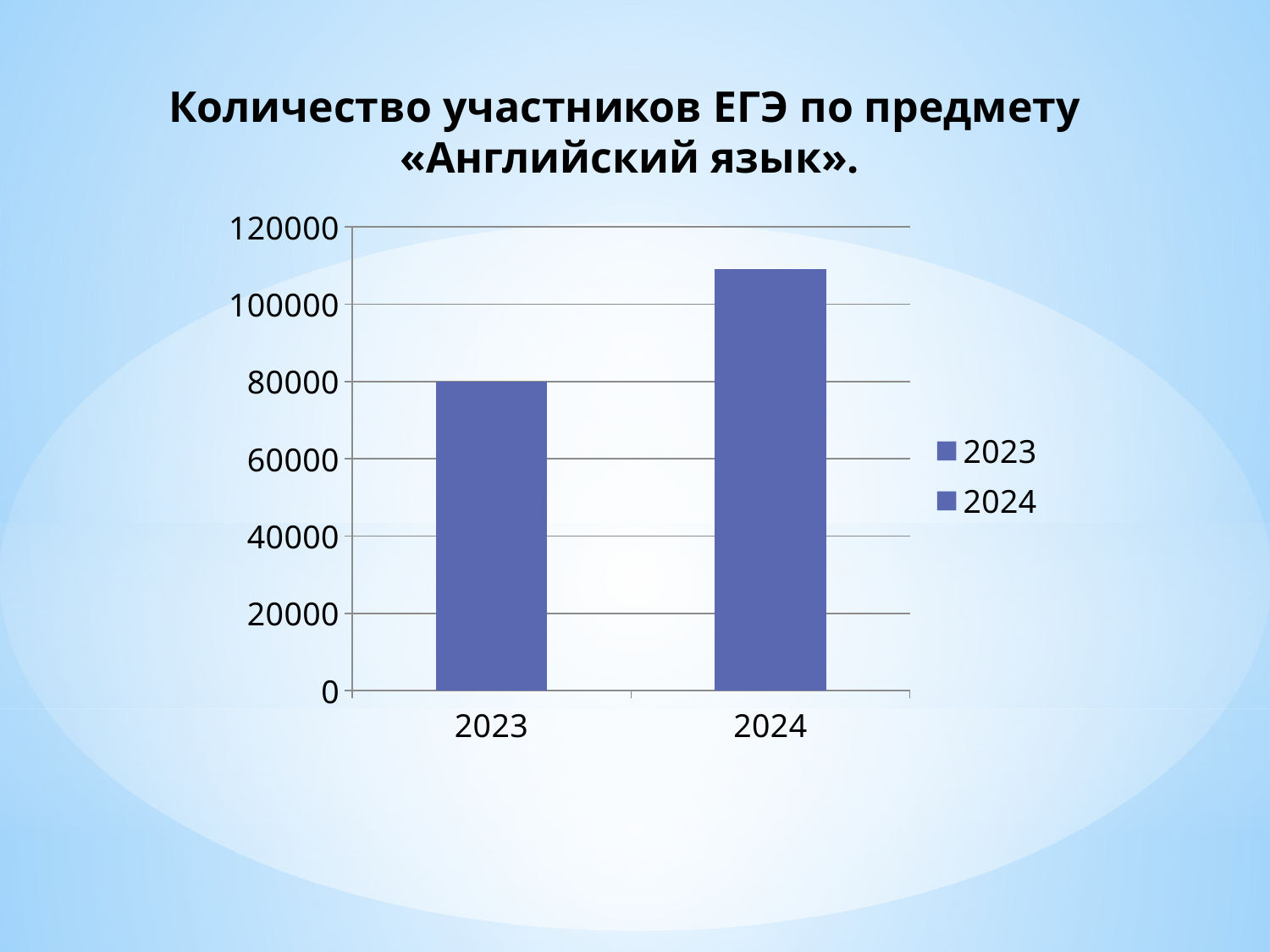
Which year has the lowest number of participants? 2023 What is the title of the chart? Количество участников ЕГЭ по предмету «Английский язык». What are the entries listed in the legend? 2023, 2024 Is the value for 2024 greater or less than 100000? greater Is the value for 2024 greater or less than 120000? less Is the value for 2023 greater or less than 100000? less What kind of chart is shown on the slide? bar chart Which year has the highest number of participants? 2024 Which is larger, the value for 2023 or the value for 2024? 2024 How many bars are plotted in the chart? 2 How many entries does the legend list? 2 Do the values rise or fall from 2023 to 2024? rise